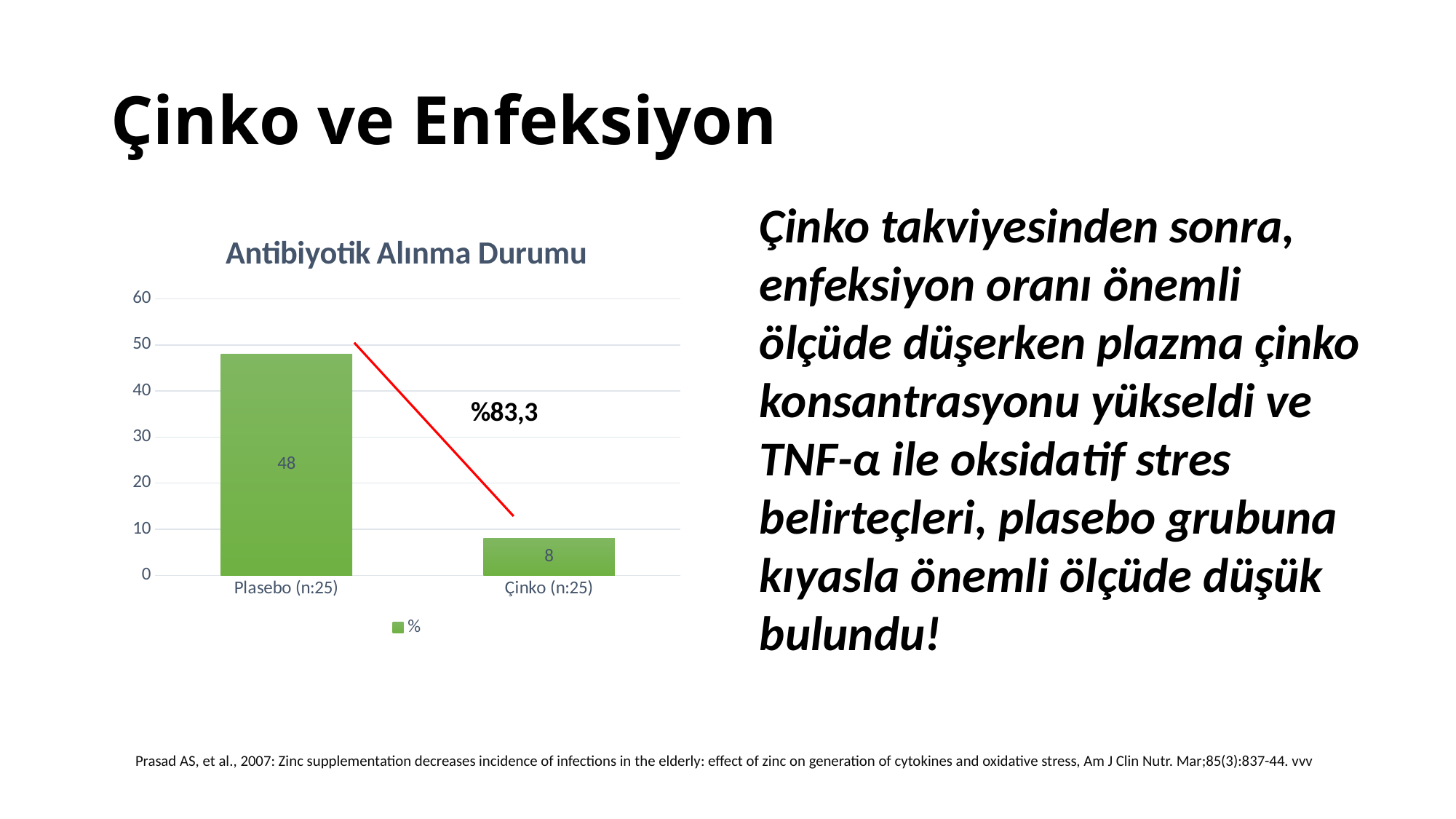
Is the value for Çinko (n:25) greater or less than 10? less Which category has the highest value? Plasebo (n:25) What is the value for Plasebo (n:25)? 48 How many series does the legend list? 1 Which is larger, the value for Plasebo (n:25) or the value for Çinko (n:25)? Plasebo (n:25) Is the value for Plasebo (n:25) greater or less than 40? greater What is the value for Çinko (n:25)? 8 What is the difference between the values for Plasebo (n:25) and Çinko (n:25)? 40 How many categories are shown on the x axis? 2 Which category has the lowest value? Çinko (n:25) What kind of chart is shown? bar chart What is the title of the chart? Antibiyotik Alınma Durumu